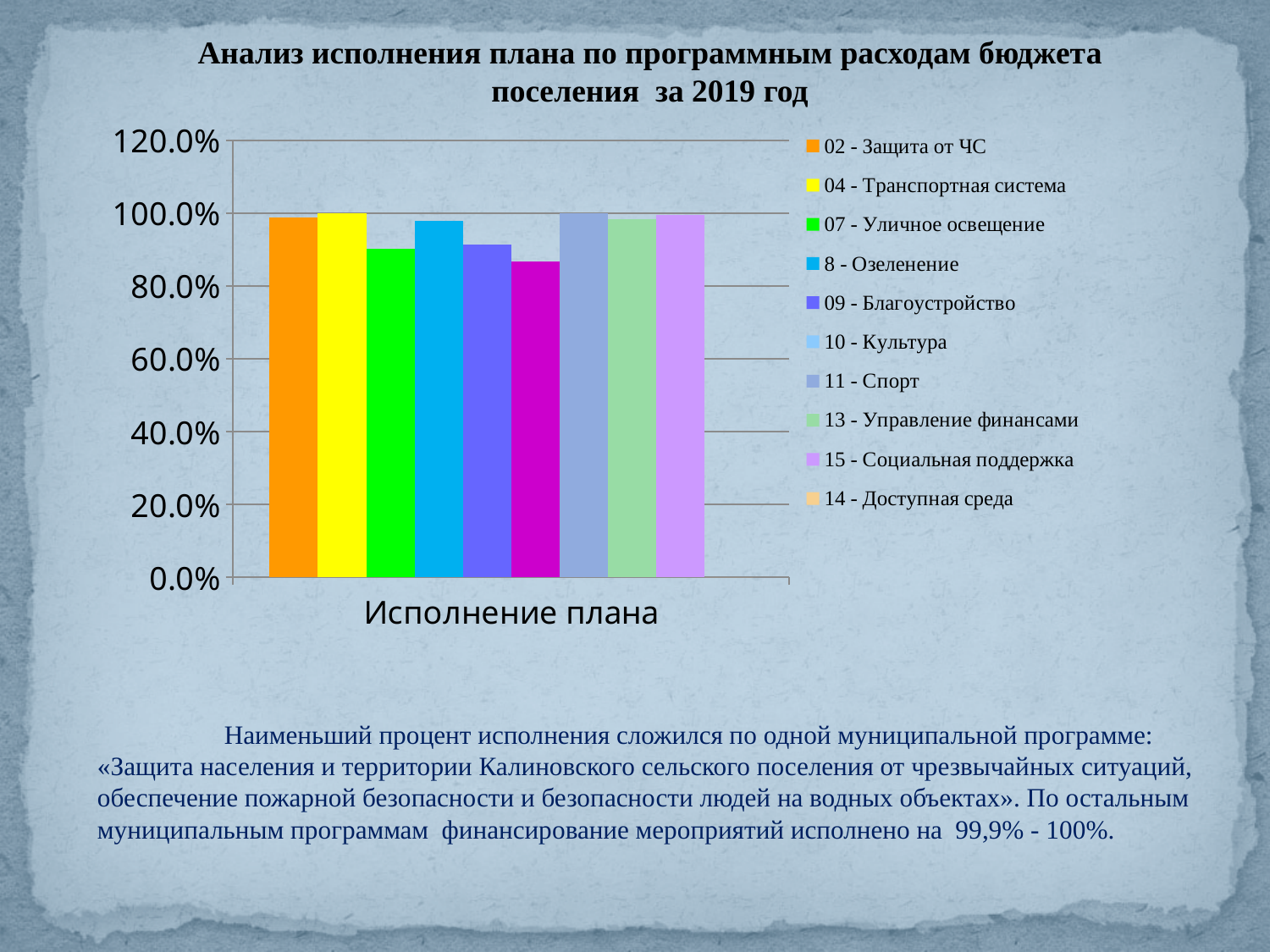
Is the value for 02 - Защита от ЧС greater or less than 80.0%? greater What is the label shown under the x axis of the chart? Исполнение плана Which is larger, the value for 04 - Транспортная система or for 07 - Уличное освещение? 04 - Транспортная система Is the value for 11 - Спорт greater or less than 80.0%? greater What kind of chart is shown on the slide? bar chart Is the value for 07 - Уличное освещение greater or less than 80.0%? greater What is the title of the chart? Анализ исполнения плана по программным расходам бюджета поселения за 2019 год How many series does the legend list? 10 Which is larger, the value for 8 - Озеленение or for 09 - Благоустройство? 8 - Озеленение How many bars are plotted in the chart? 9